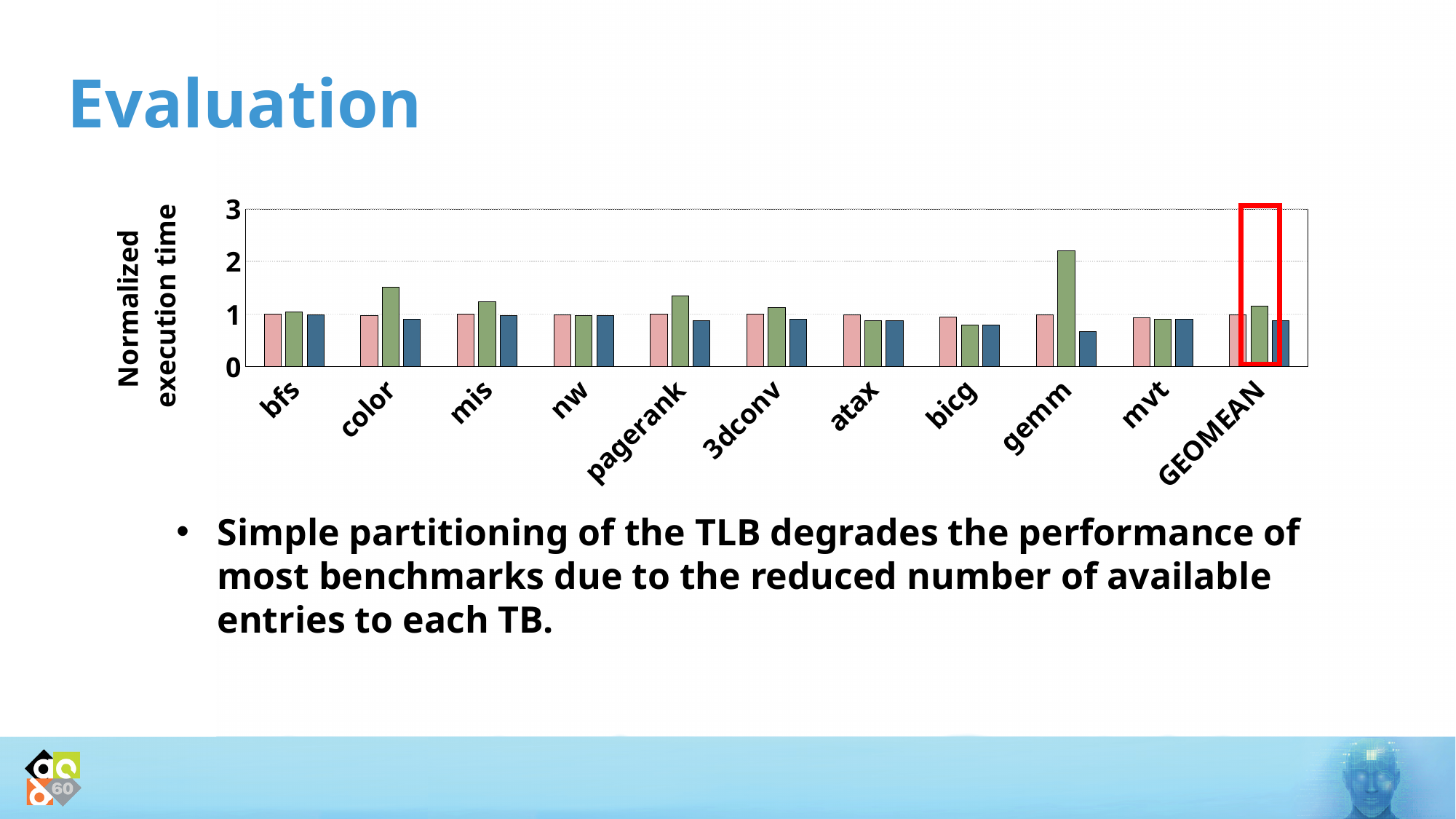
What kind of chart is shown on the slide? bar chart What is the label of the y axis of the chart? Normalized execution time Which is larger, the green bar for color or the green bar for mis? color How many benchmark categories are shown along the x axis of the chart? 11 Is the green bar for gemm greater or less than 2? greater Is the green bar for color greater or less than 1? greater What is the highest tick value shown on the y axis of the chart? 3 Which is larger, the green bar for gemm or the green bar for color? gemm How many bars are plotted for each category in the chart? 3 Is the green bar for color greater or less than 2? less Which category has the tallest bar in the chart? gemm